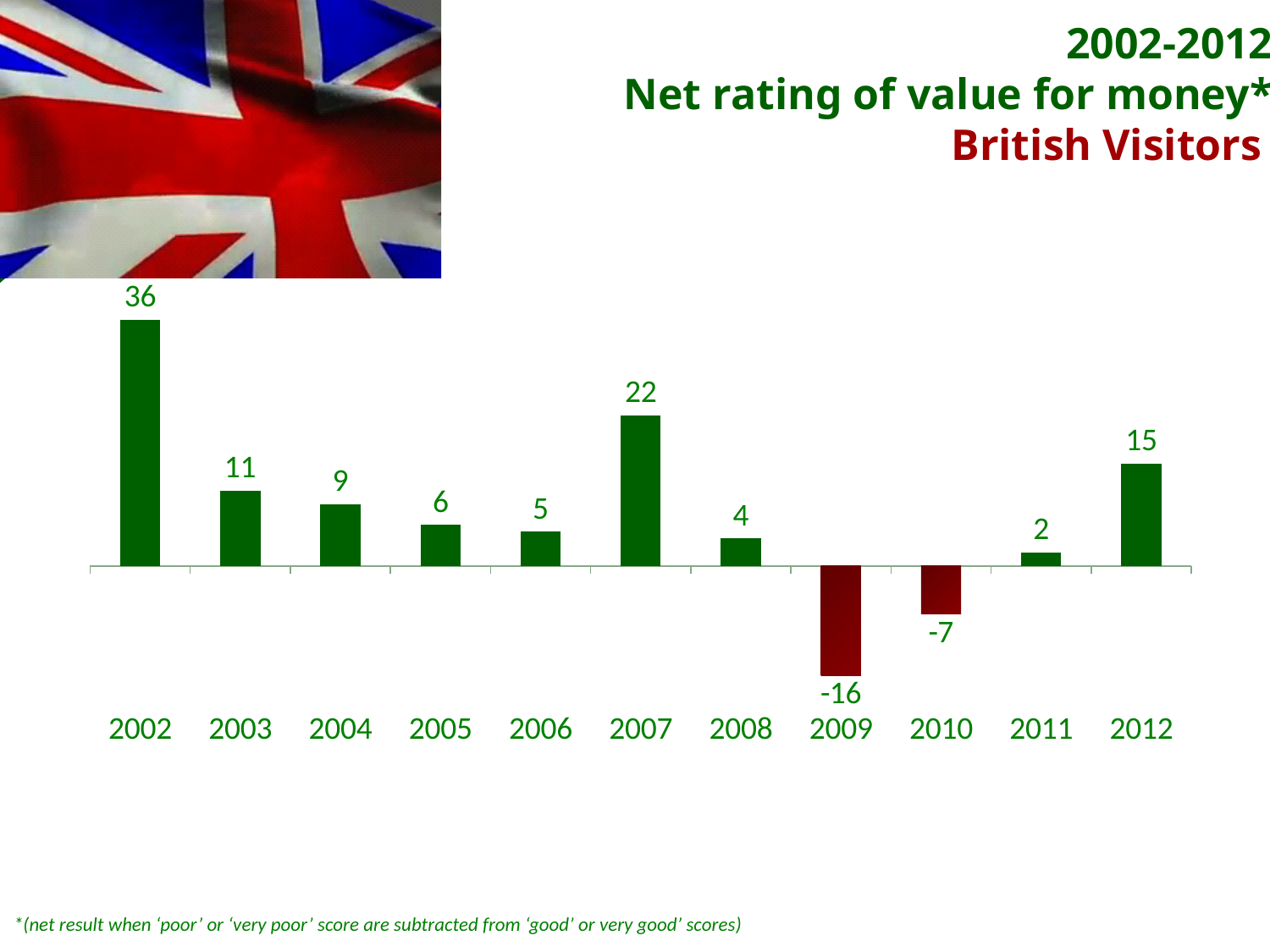
What is the difference between the net rating in 2002 and the net rating in 2007? 14 What is the difference between the net rating in 2012 and the net rating in 2011? 13 How many years are shown on the chart? 11 Which year has the highest net rating of value for money? 2002 Which year has the lowest net rating of value for money? 2009 What is the net rating of value for money for British visitors in 2009? -16 What kind of chart is shown on the slide? Bar chart Which year has a higher net rating, 2003 or 2004? 2003 What is the net rating of value for money for British visitors in 2002? 36 How many years have a negative net rating? 2 Does the net rating rise or fall from 2002 to 2006? Fall What is the net rating of value for money for British visitors in 2012? 15